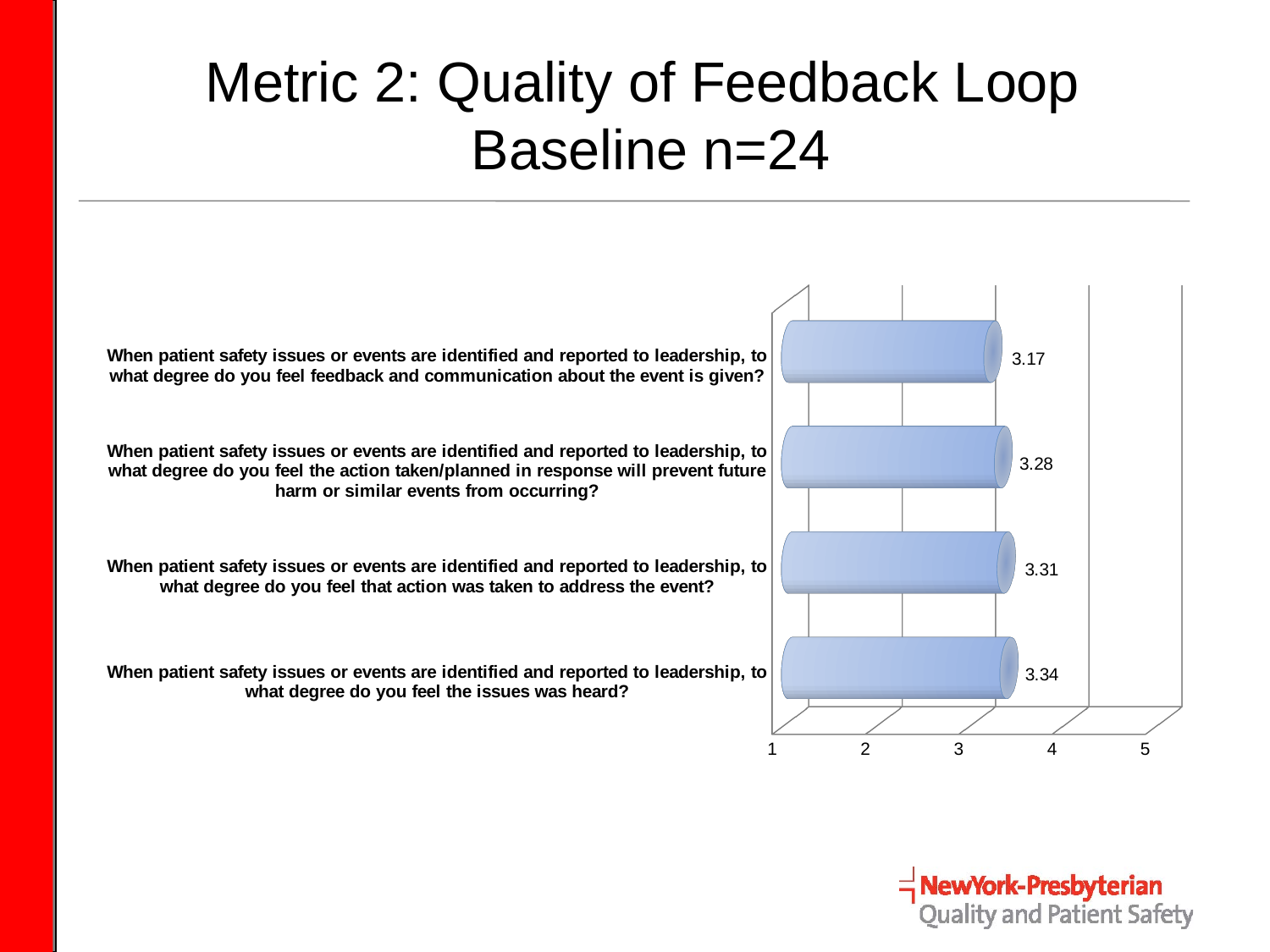
Is the value for the question about feedback and communication being given greater or less than 4? less What is the maximum value shown on the chart's value axis? 5 What kind of chart is shown on the slide? Bar chart What is the difference between the value for the question about the issue being heard and the value for the question about feedback and communication being given? 0.17 Which is larger: the value for the question about action being taken to address the event, or the value for the question about the action preventing future harm? The question about action being taken to address the event What is the value for the question about whether the action taken/planned will prevent future harm or similar events? 3.28 Which question has the highest value? When patient safety issues or events are identified and reported to leadership, to what degree do you feel the issues was heard? What is the value for the question about the degree to which feedback and communication about the event is given? 3.17 How many questions (categories) are shown in the chart? 4 What is the value for the question about the degree to which action was taken to address the event? 3.31 What is the value for the question about the degree to which the issue was heard? 3.34 Which question has the lowest value? When patient safety issues or events are identified and reported to leadership, to what degree do you feel feedback and communication about the event is given?